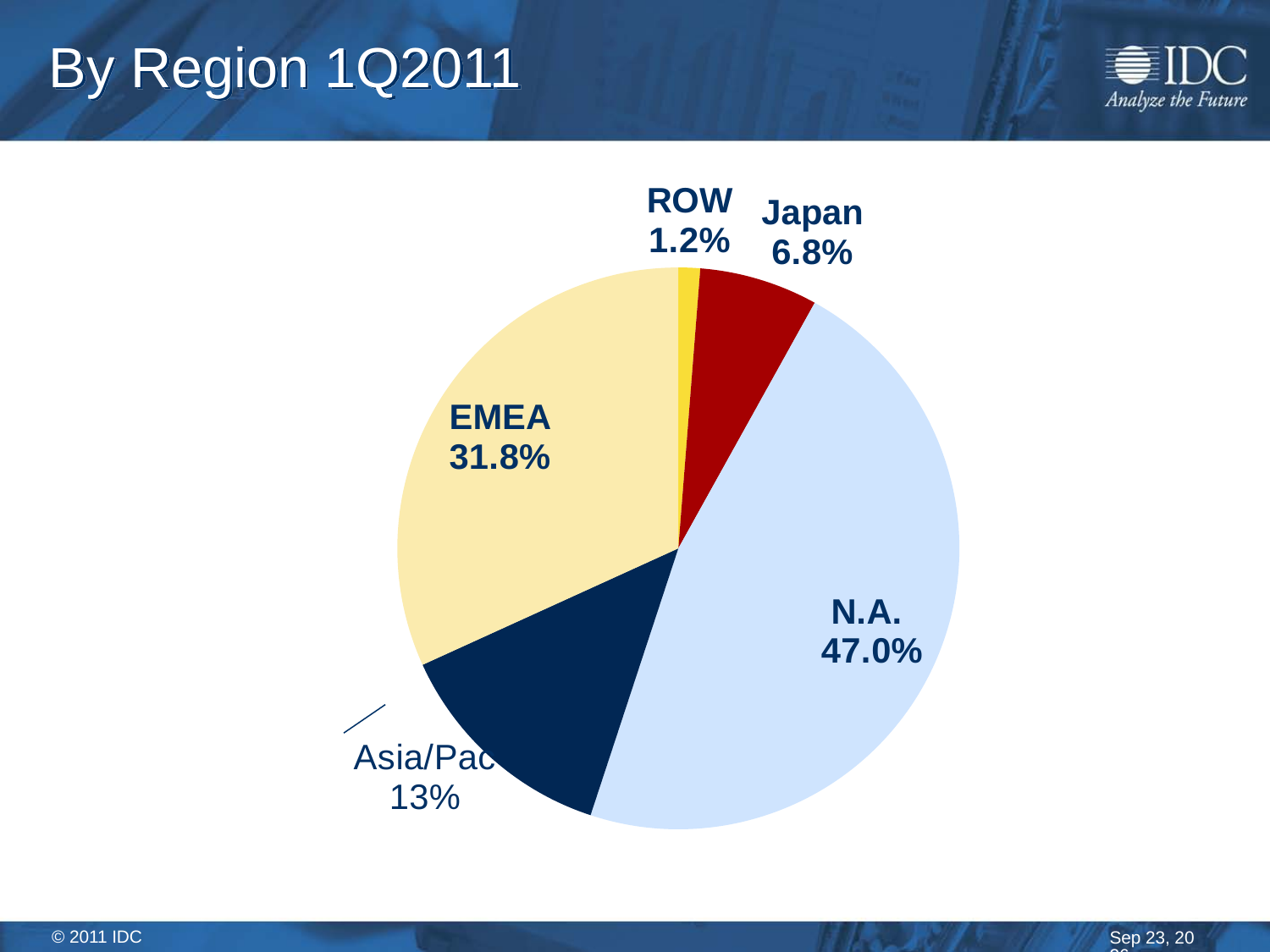
What is the value shown for EMEA? 31.8% What type of chart is shown on the slide? Pie chart Which region has the smallest slice of the pie? ROW What share of the pie does N.A. hold? 47.0% Which is larger, the EMEA slice or the Asia/Pac slice? EMEA Which region has the largest slice of the pie? N.A. What is the title of the slide containing the chart? By Region 1Q2011 What percentage is labelled for Japan? 6.8% What is the difference between the Japan and ROW shares? 5.6 percentage points What is the value shown for Asia/Pac? 13% How many percentage points larger is N.A. than EMEA? 15.2 percentage points How many regions are shown in the pie chart? 5